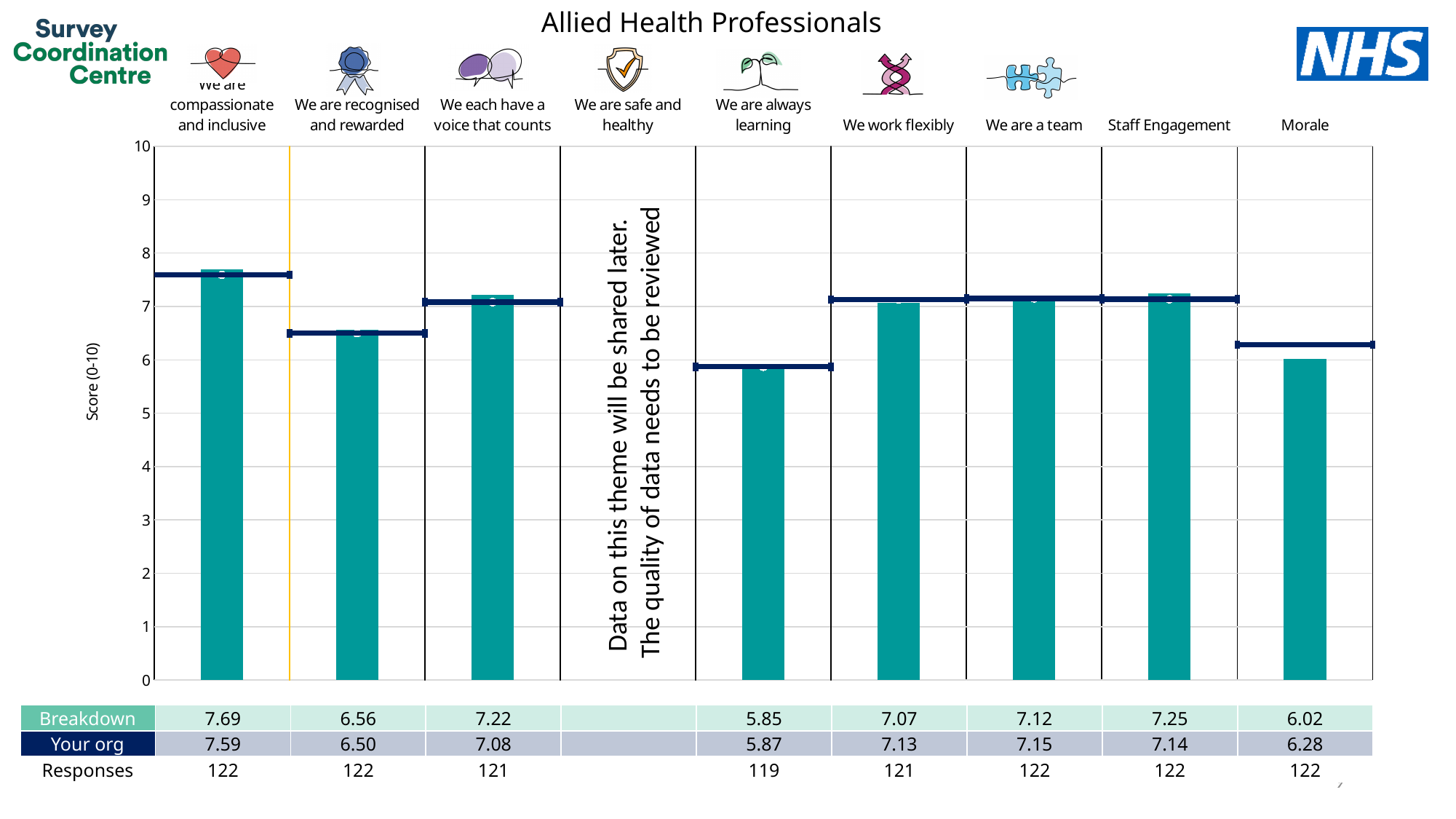
What is the Breakdown score for 'We are compassionate and inclusive'? 7.69 What kind of chart is shown on the slide? bar chart What is the Your org score for 'Morale'? 6.28 Which theme has the highest Breakdown score? We are compassionate and inclusive How many responses are recorded for 'We are always learning'? 119 What is the label on the vertical axis of the chart? Score (0-10) Is the Breakdown bar for 'We are always learning' greater or less than 6? less Which theme has the lowest Breakdown score? We are always learning What is the difference between the Your org score and the Breakdown score for 'Morale'? 0.26 How many themes have a bar plotted on the chart? 8 Which is larger for 'We are recognised and rewarded': the Breakdown score or the Your org score? Breakdown Which theme has no data plotted on the chart? We are safe and healthy